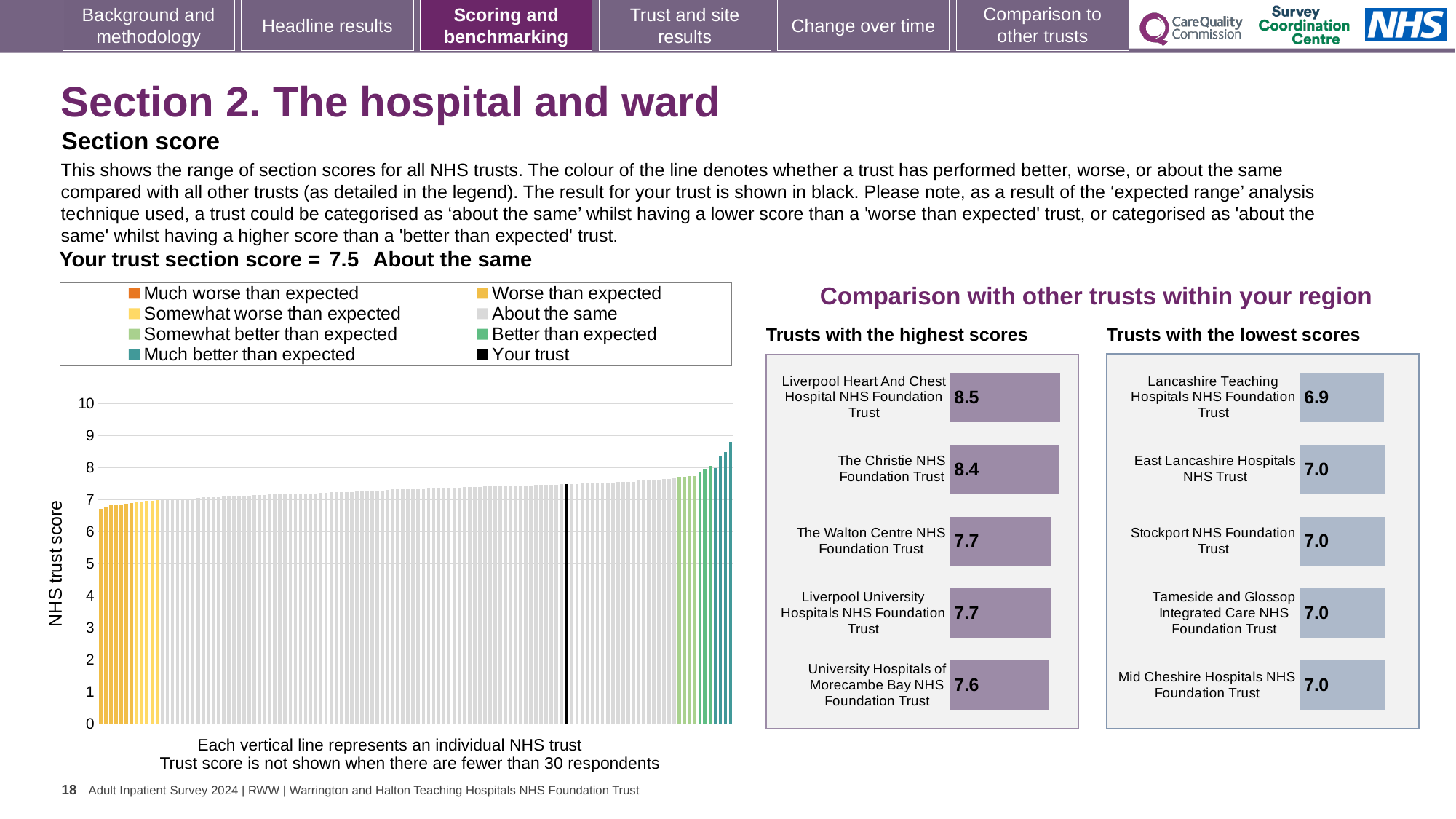
What kind of chart is the large chart on the left showing NHS trust scores? Bar chart In the 'Trusts with the lowest scores' chart, which trust has the lowest score? Lancashire Teaching Hospitals NHS Foundation Trust In the 'Trusts with the highest scores' chart, what is the difference between the scores of Liverpool Heart And Chest Hospital NHS Foundation Trust and University Hospitals of Morecambe Bay NHS Foundation Trust? 0.9 In the 'Trusts with the lowest scores' chart, what is the score for Lancashire Teaching Hospitals NHS Foundation Trust? 6.9 In the 'Trusts with the lowest scores' chart, what is the difference between the scores of East Lancashire Hospitals NHS Trust and Lancashire Teaching Hospitals NHS Foundation Trust? 0.1 In the 'Trusts with the highest scores' chart, which has the larger score: The Christie NHS Foundation Trust or The Walton Centre NHS Foundation Trust? The Christie NHS Foundation Trust In the 'Trusts with the highest scores' chart, which trust has the lowest score? University Hospitals of Morecambe Bay NHS Foundation Trust In the 'Trusts with the highest scores' chart, what is the score for Liverpool Heart And Chest Hospital NHS Foundation Trust? 8.5 In the 'Trusts with the highest scores' chart, what is the score for The Christie NHS Foundation Trust? 8.4 In the 'Trusts with the lowest scores' chart, how many trusts are shown? 5 How many entries does the legend of the large chart on the left list? 8 In the large chart on the left, is the value of the lowest bar greater or less than 7? less